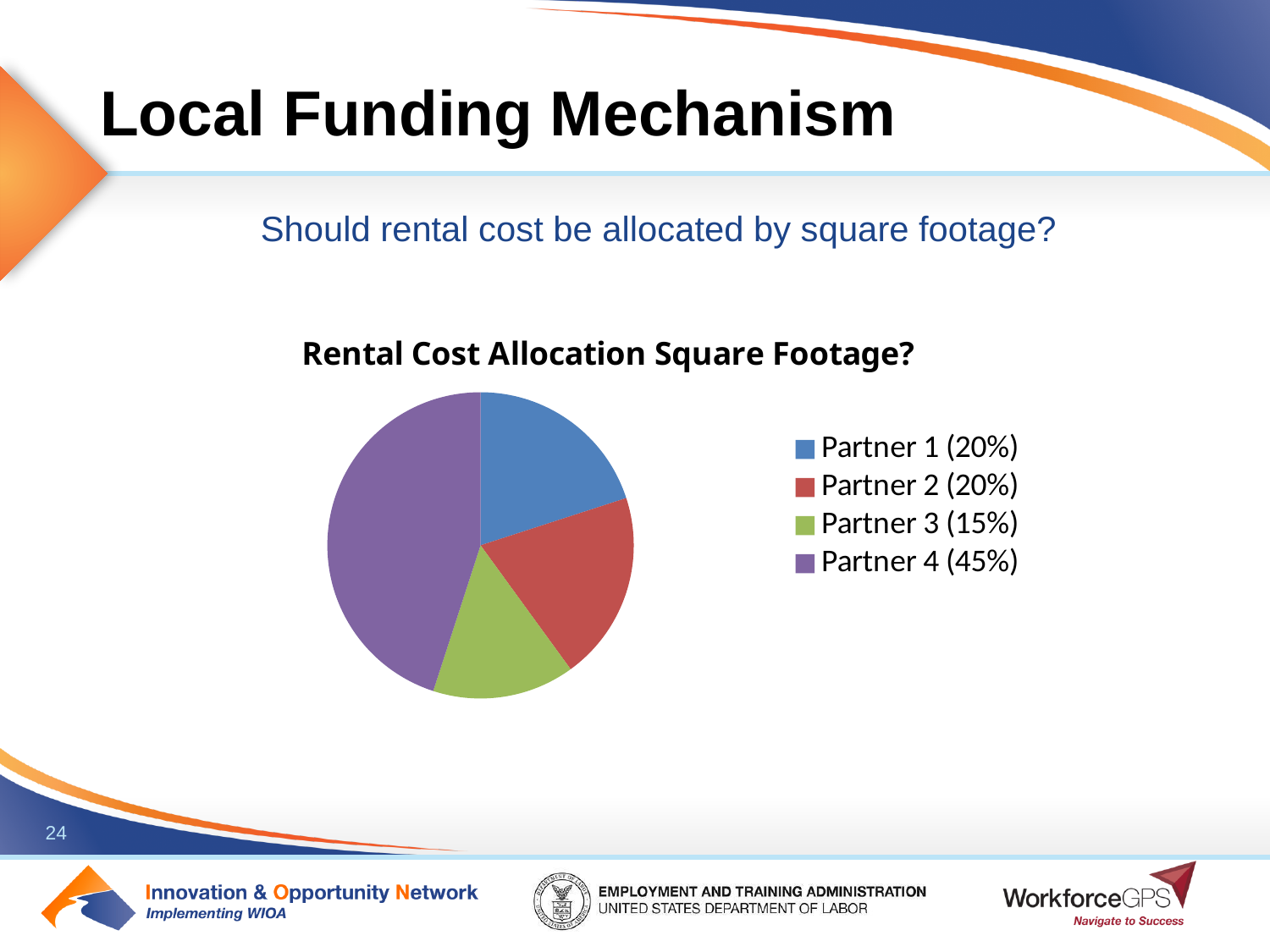
What share of the pie does Partner 3 represent? 15% What percentage is shown for Partner 1 in the legend? 20% Which partner has the smallest share of the pie? Partner 3 How many slices does the pie chart have? 4 What kind of chart is shown on the slide? Pie chart What is the title of the chart? Rental Cost Allocation Square Footage? What is the combined share of Partner 1 and Partner 2? 40% Which partner has the largest share of the pie? Partner 4 What colour is the slice for Partner 4? Purple What is the difference in percentage points between Partner 4 and Partner 3? 30 Which is larger, the share for Partner 2 or the share for Partner 3? Partner 2 What share of the pie does Partner 4 represent? 45%